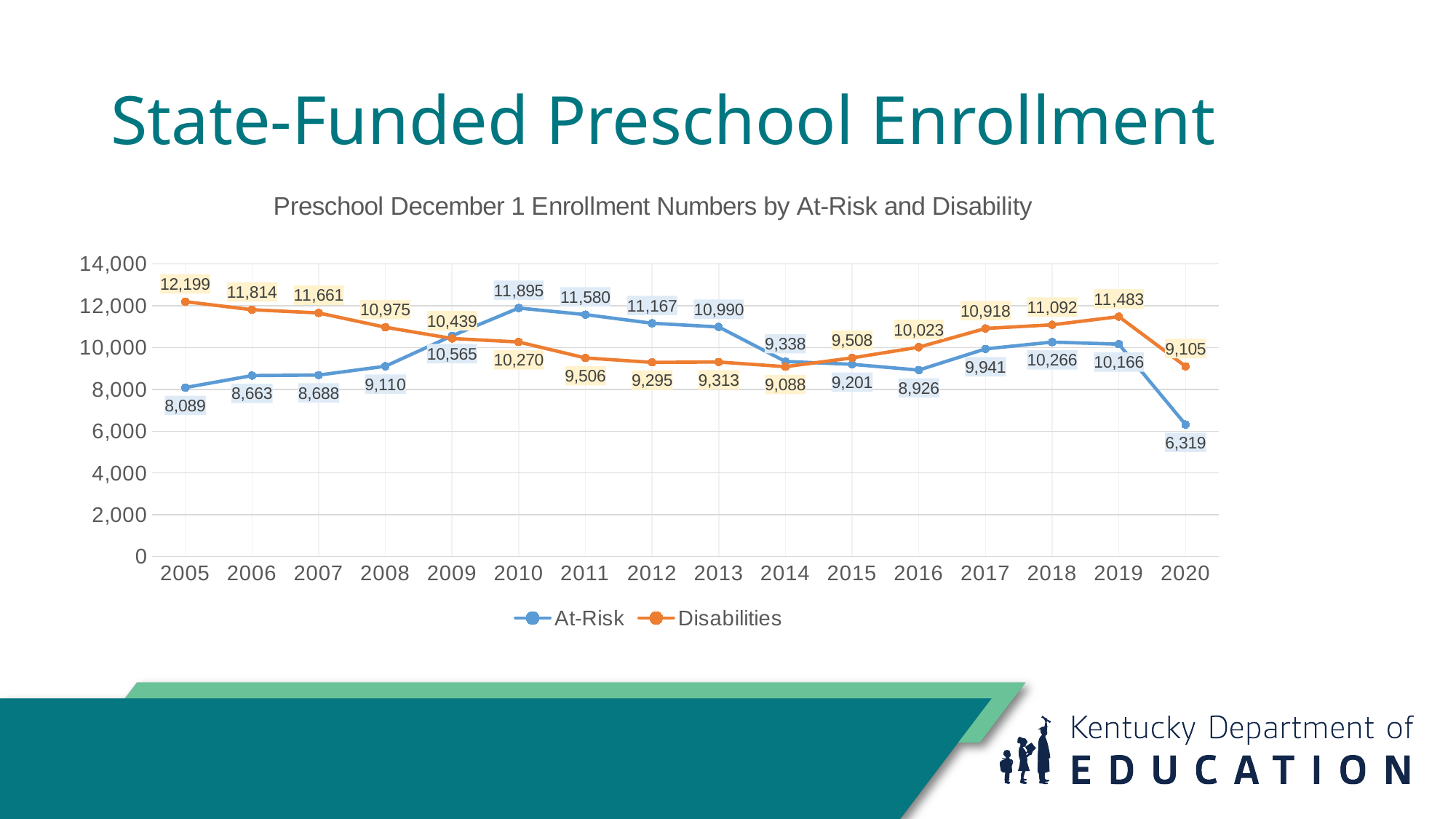
What kind of chart is shown on the slide? Line chart What was the At-Risk enrollment in 2010? 11,895 In which year was At-Risk enrollment highest? 2010 What is the difference between Disabilities and At-Risk enrollment in 2020? 2,786 What was the Disabilities enrollment in 2005? 12,199 What is the title of the chart? Preschool December 1 Enrollment Numbers by At-Risk and Disability How many series does the legend list? 2 In which year was At-Risk enrollment lowest? 2020 What is the lowest Disabilities enrollment value shown? 9,088 In 2015, which series had the higher enrollment, At-Risk or Disabilities? Disabilities How many years are plotted along the x axis? 16 Did At-Risk enrollment rise or fall from 2010 to 2016? Fall